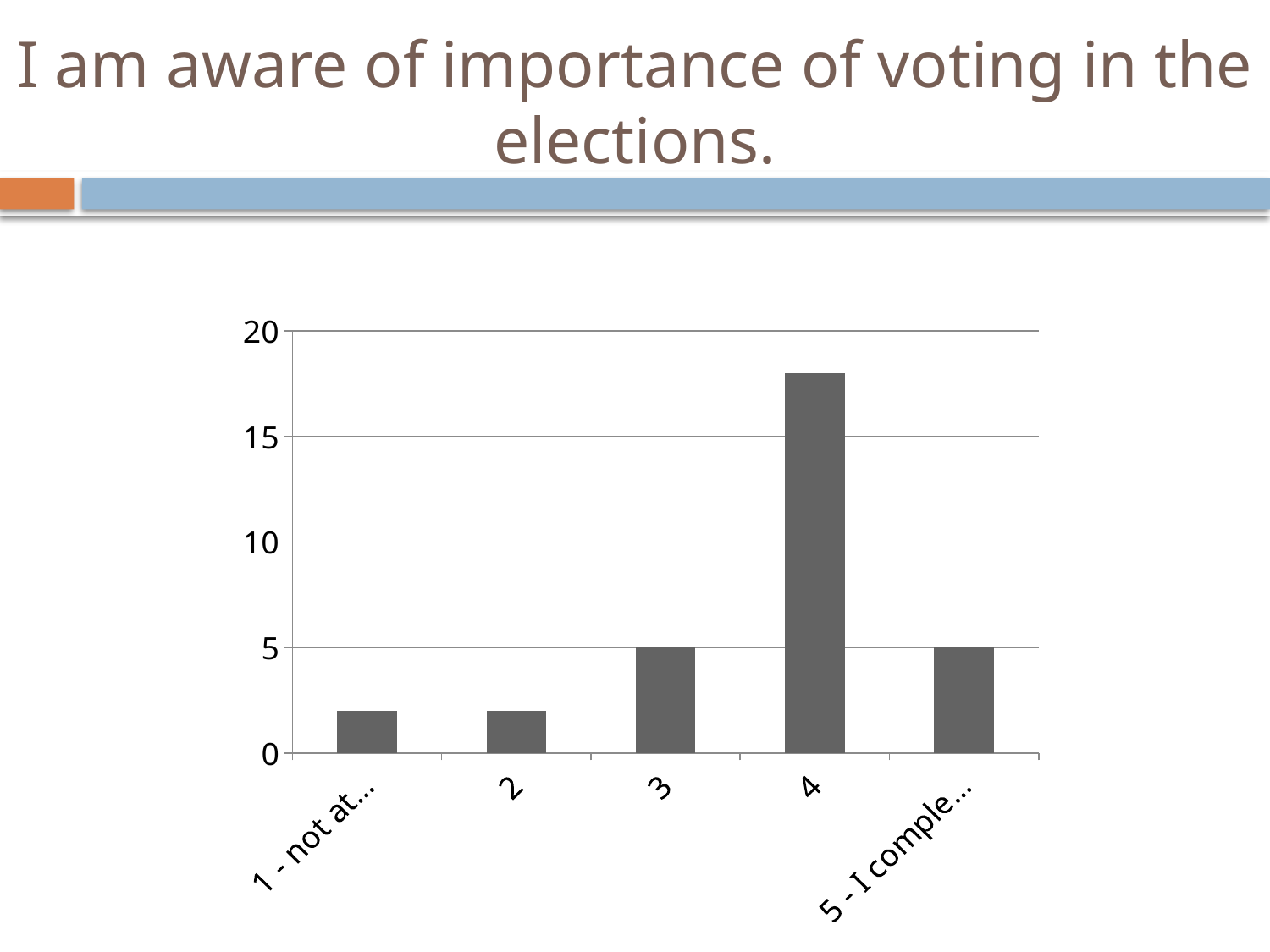
Is the value for category 2 greater or less than 5? less What is the value for the category labelled "5 - I comple..."? 5 Is the value for category 4 greater or less than 15? greater What is the highest value shown on the y axis of the chart? 20 What is the value for category 3? 5 Which is larger, the value for category 4 or the value for category 3? 4 What kind of chart is shown on the slide? bar chart How many categories are shown on the x axis of the chart? 5 What is the title of the slide containing the chart? I am aware of importance of voting in the elections. Which category has the highest bar in the chart? 4 Is the value for the category labelled "1 - not at..." greater or less than 5? less Which is larger, the value for category 2 or the value for category 3? 3